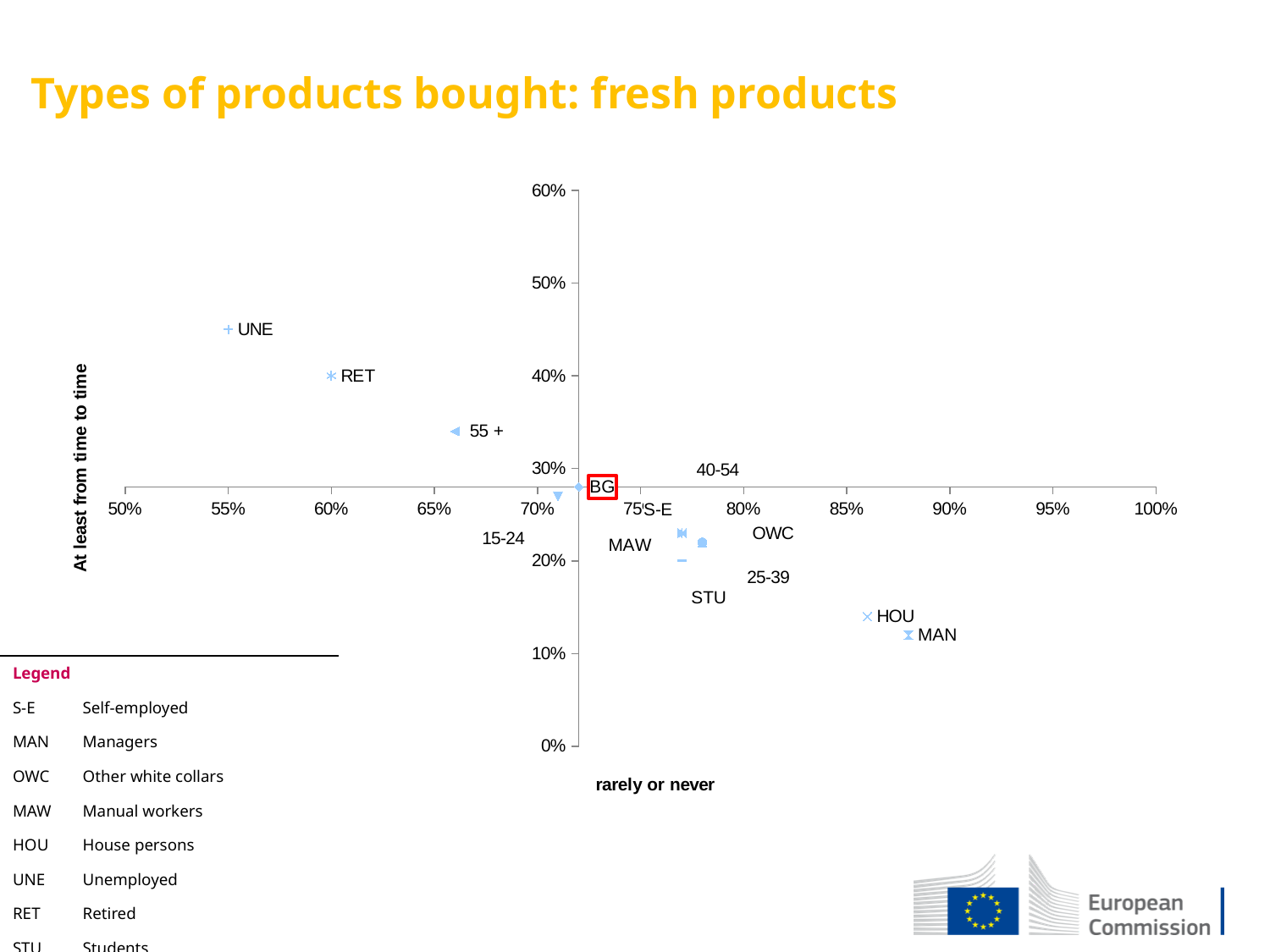
Is the horizontal-axis value for UNE greater or less than 60%? less What kind of chart is shown on the slide? scatter chart Which has the higher vertical-axis value, 55 + or HOU? 55 + Is the vertical-axis value for MAN greater or less than 20%? less Is the horizontal-axis value for HOU greater or less than 80%? greater Which labeled point has the lowest value on the vertical axis (At least from time to time)? MAN Which labeled point has the lowest value on the horizontal axis (rarely or never)? UNE Which labeled point has the highest value on the vertical axis (At least from time to time)? UNE What is the title of the chart on the slide? Types of products bought: fresh products What is the label of the vertical axis of the chart? At least from time to time As the 'rarely or never' value increases along the horizontal axis, do the points generally rise or fall on the vertical axis? fall